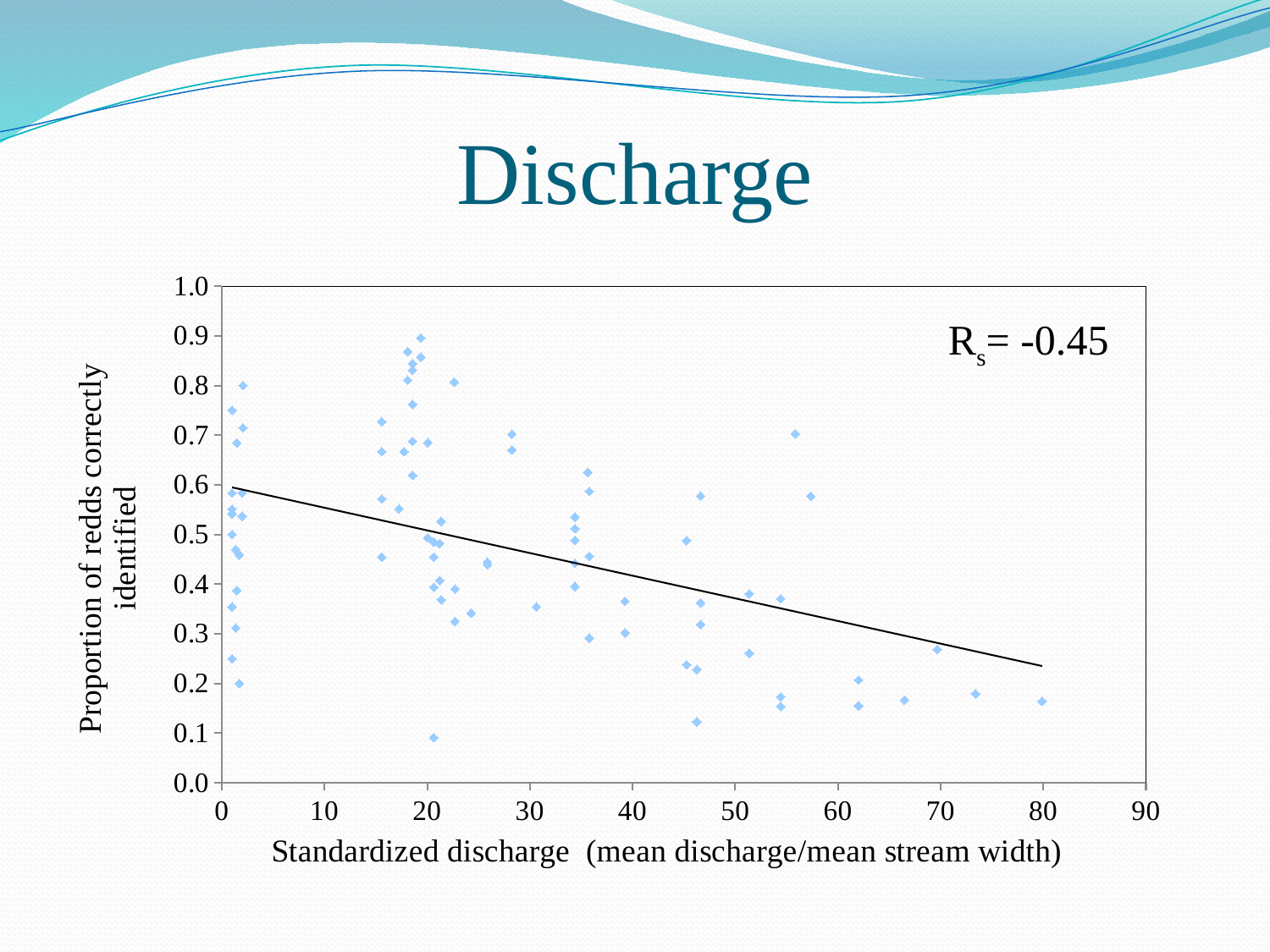
Is the value of the trend line at a standardized discharge of 0 greater or less than 0.5? greater Is the lowest plotted point on the chart greater or less than 0.2? less What correlation value (Rs) is printed on the chart? -0.45 Is the value of the trend line at a standardized discharge of 80 greater or less than 0.3? less What is the label of the y axis? Proportion of redds correctly identified Do the plotted values generally rise or fall as standardized discharge increases along the x axis? fall Is the correlation coefficient shown on the chart positive or negative? negative What is the title of the slide containing the chart? Discharge What is the highest tick value shown on the y axis? 1.0 What is the highest tick value shown on the x axis? 90 What kind of chart is shown on the slide? scatter chart